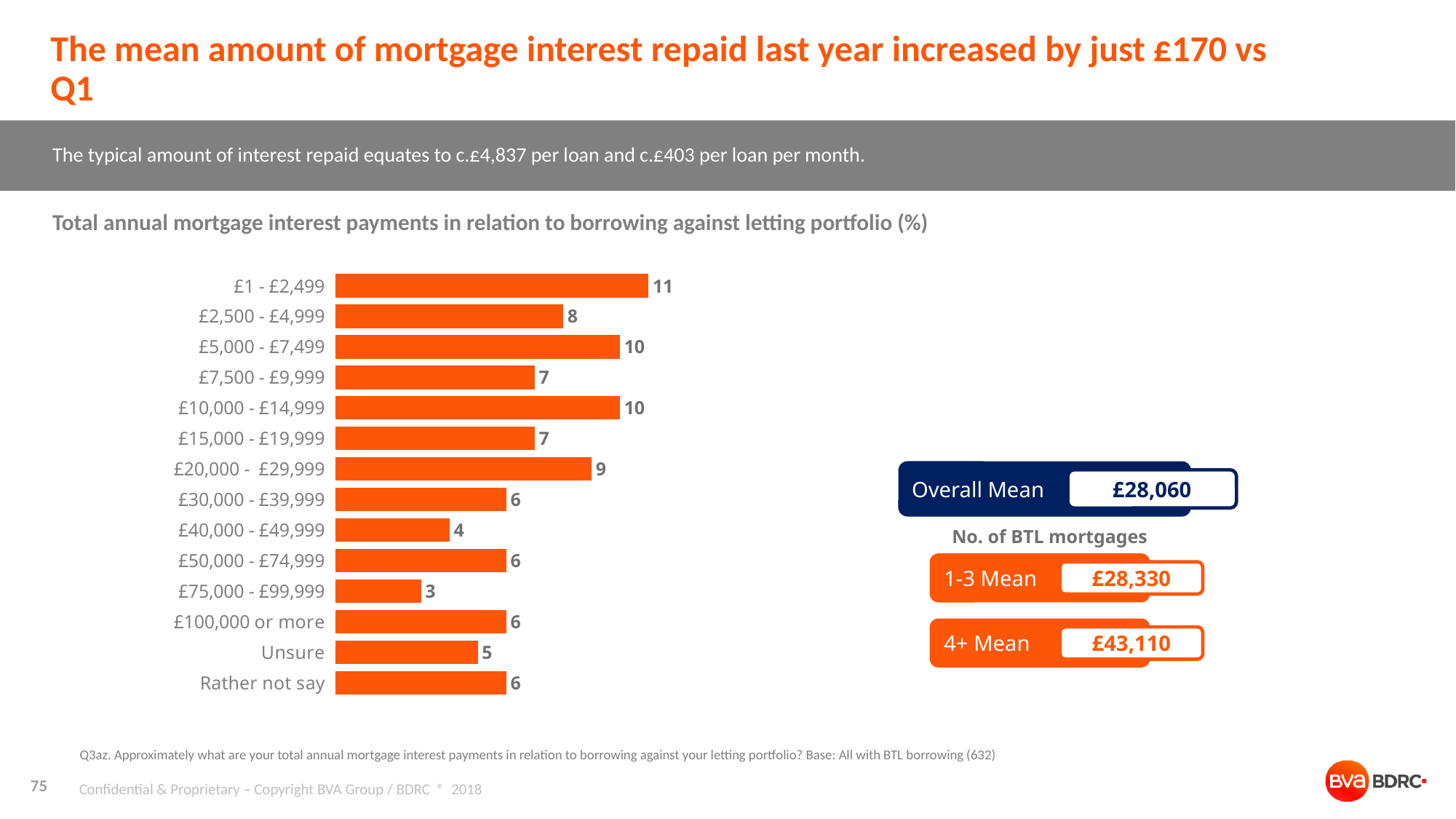
Which is larger, the value for £20,000 - £29,999 or the value for £30,000 - £39,999? £20,000 - £29,999 How many categories are shown in the bar chart? 14 Which category has the highest value? £1 - £2,499 Which category has the lowest value? £75,000 - £99,999 What is the value for the £1 - £2,499 category? 11 What is the value for the Unsure category? 5 What kind of chart is shown on the slide? Bar chart What is the title of the chart? Total annual mortgage interest payments in relation to borrowing against letting portfolio (%) What colour are the bars in the chart? Orange What is the value for the £40,000 - £49,999 category? 4 What is the difference between the values for £1 - £2,499 and £2,500 - £4,999? 3 What is the value for the £100,000 or more category? 6